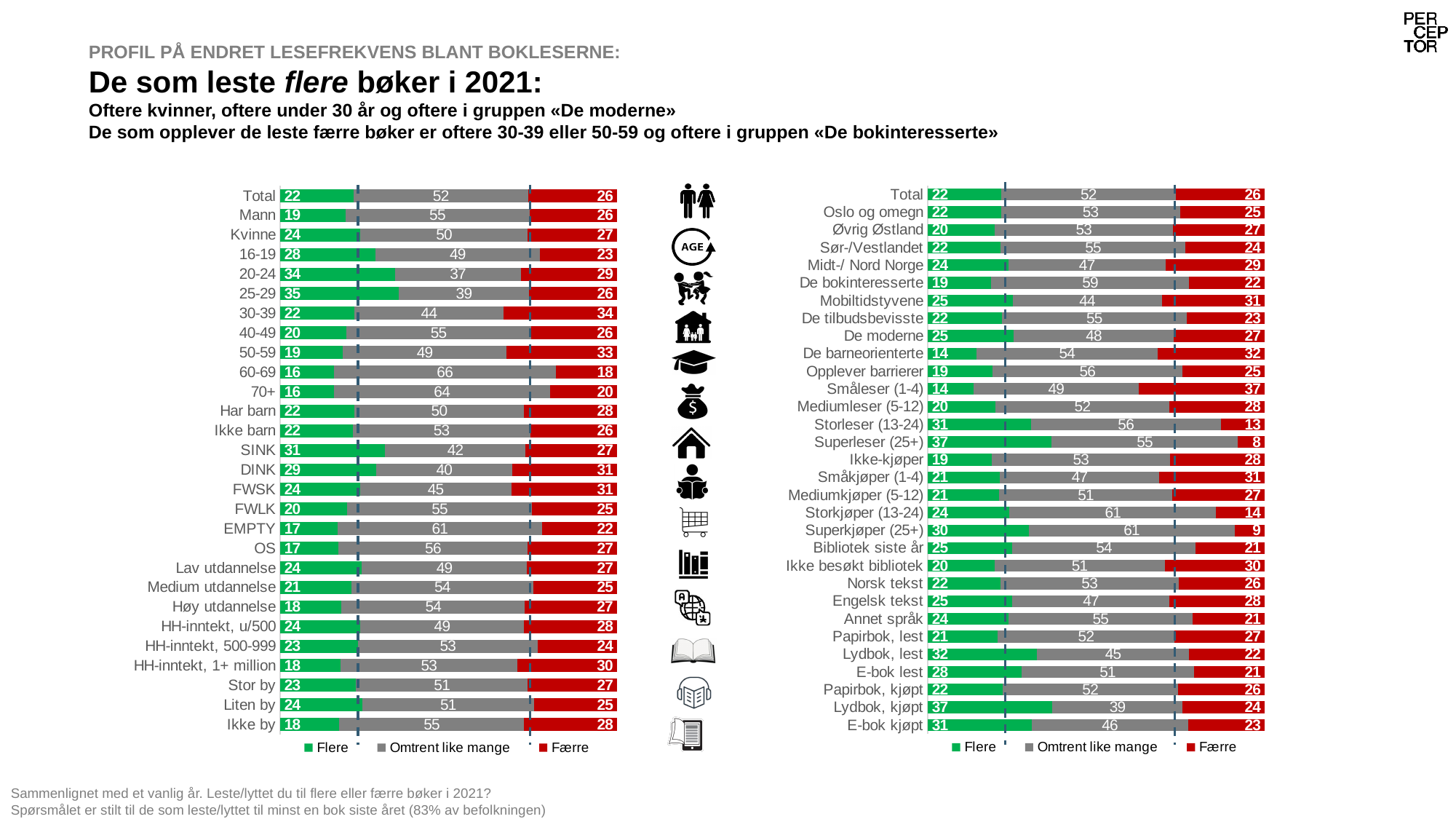
How many series does the legend of the right chart list? 3 In the right chart, which category has the highest 'Færre' value? Småleser (1-4) In the left chart, what is the total of the stacked bar for Total? 100 In the left chart, what is the 'Flere' value for 25-29? 35 In the right chart, which category has the lowest 'Færre' value? Superleser (25+) How many categories are shown in the right chart? 31 What type of chart is the left chart? Stacked bar chart In the right chart, which has a larger 'Flere' value: Lydbok, lest or Papirbok, lest? Lydbok, lest In the right chart, what is the 'Færre' value for Superleser (25+)? 8 In the left chart, what is the difference between the 'Omtrent like mange' values for 60-69 and 20-24? 29 In the left chart, which category has the highest 'Færre' value? 30-39 How many categories are shown in the left chart? 28